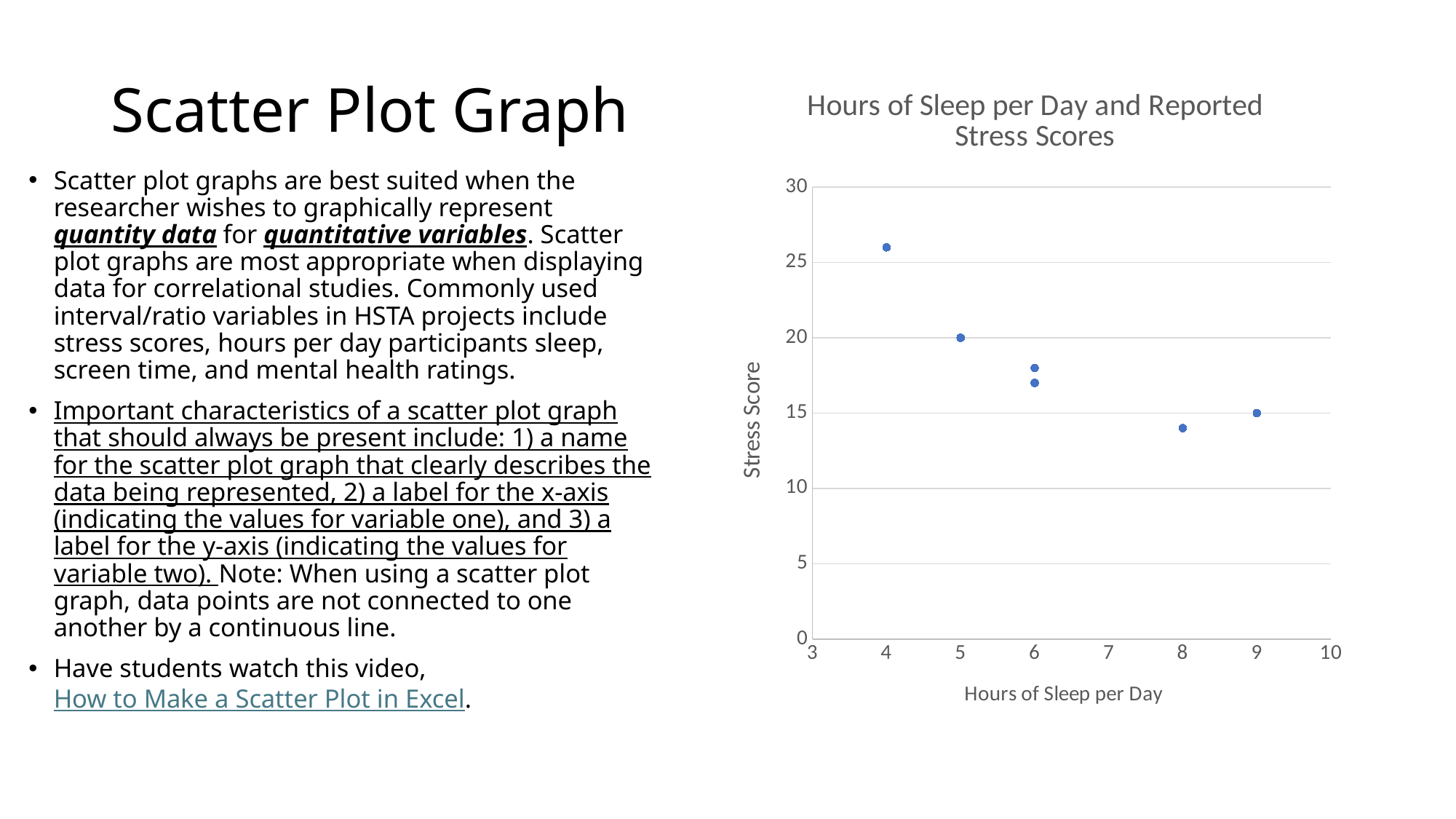
At which number of hours of sleep per day is the lowest stress score plotted? 8 What is the title of the chart? Hours of Sleep per Day and Reported Stress Scores Which has the higher stress score: the point at 4 hours of sleep or the point at 8 hours of sleep? 4 hours of sleep Are the stress scores for the points at 6 hours of sleep greater or less than 20? less What kind of chart is shown on the slide? scatter plot Is the stress score for the point at 9 hours of sleep greater or less than 20? less At which number of hours of sleep per day is the highest stress score plotted? 4 Is the stress score for the point at 4 hours of sleep greater or less than 25? greater What is the label of the y-axis of the chart? Stress Score As hours of sleep per day increase along the x-axis, do the stress scores generally rise or fall? fall